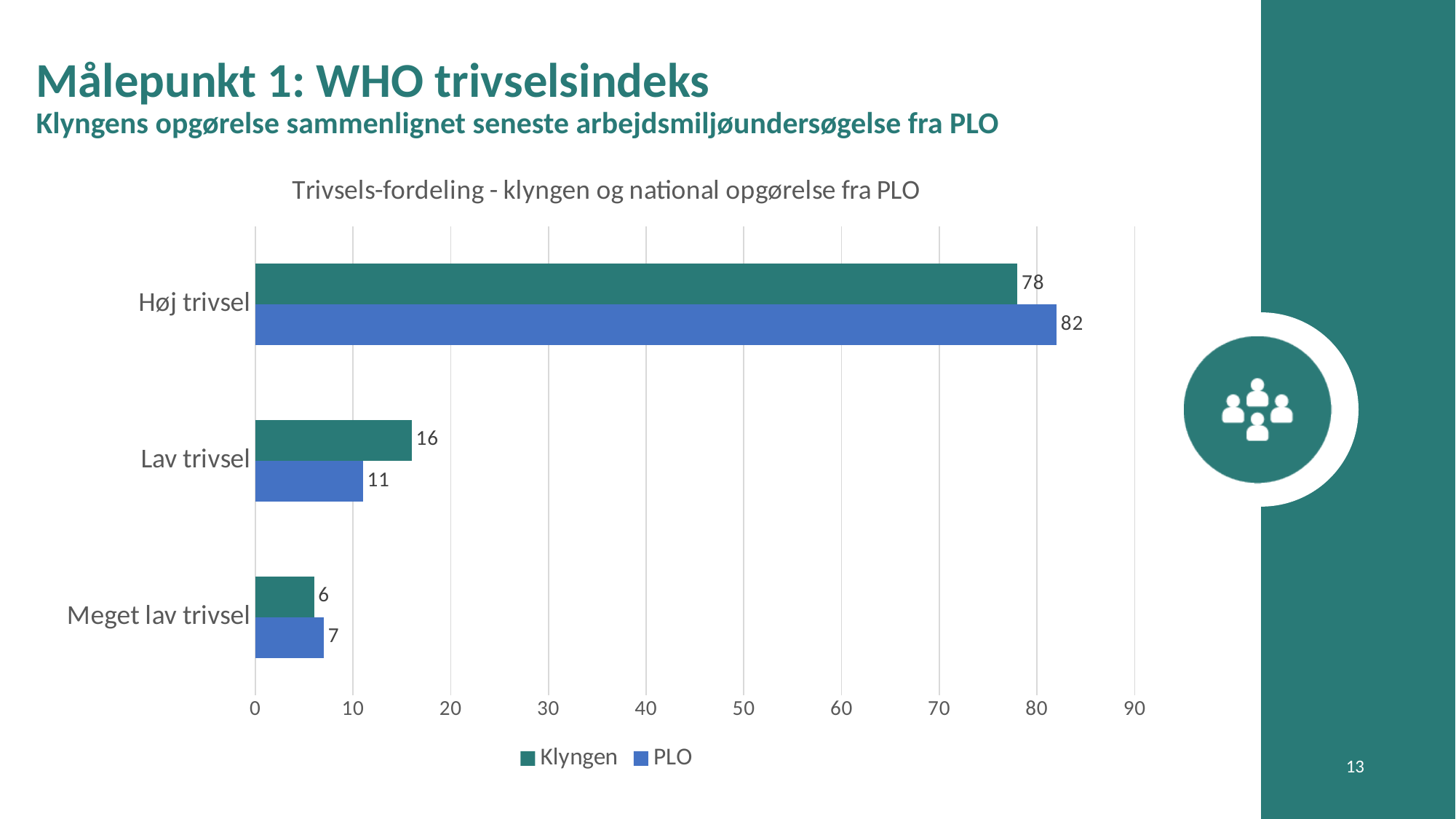
What is the PLO value for Høj trivsel? 82 What is the difference between the Klyngen and PLO values for Lav trivsel? 5 How many categories are shown on the y axis? 3 Which category has the lowest Klyngen value? Meget lav trivsel What kind of chart is shown on the slide? Bar chart What is the difference between the PLO and Klyngen values for Høj trivsel? 4 Which category has the highest PLO value? Høj trivsel What is the Klyngen value for Lav trivsel? 16 For Lav trivsel, which series has the larger value, Klyngen or PLO? Klyngen How many series does the legend list? 2 What is the PLO value for Meget lav trivsel? 7 What is the Klyngen value for Høj trivsel? 78